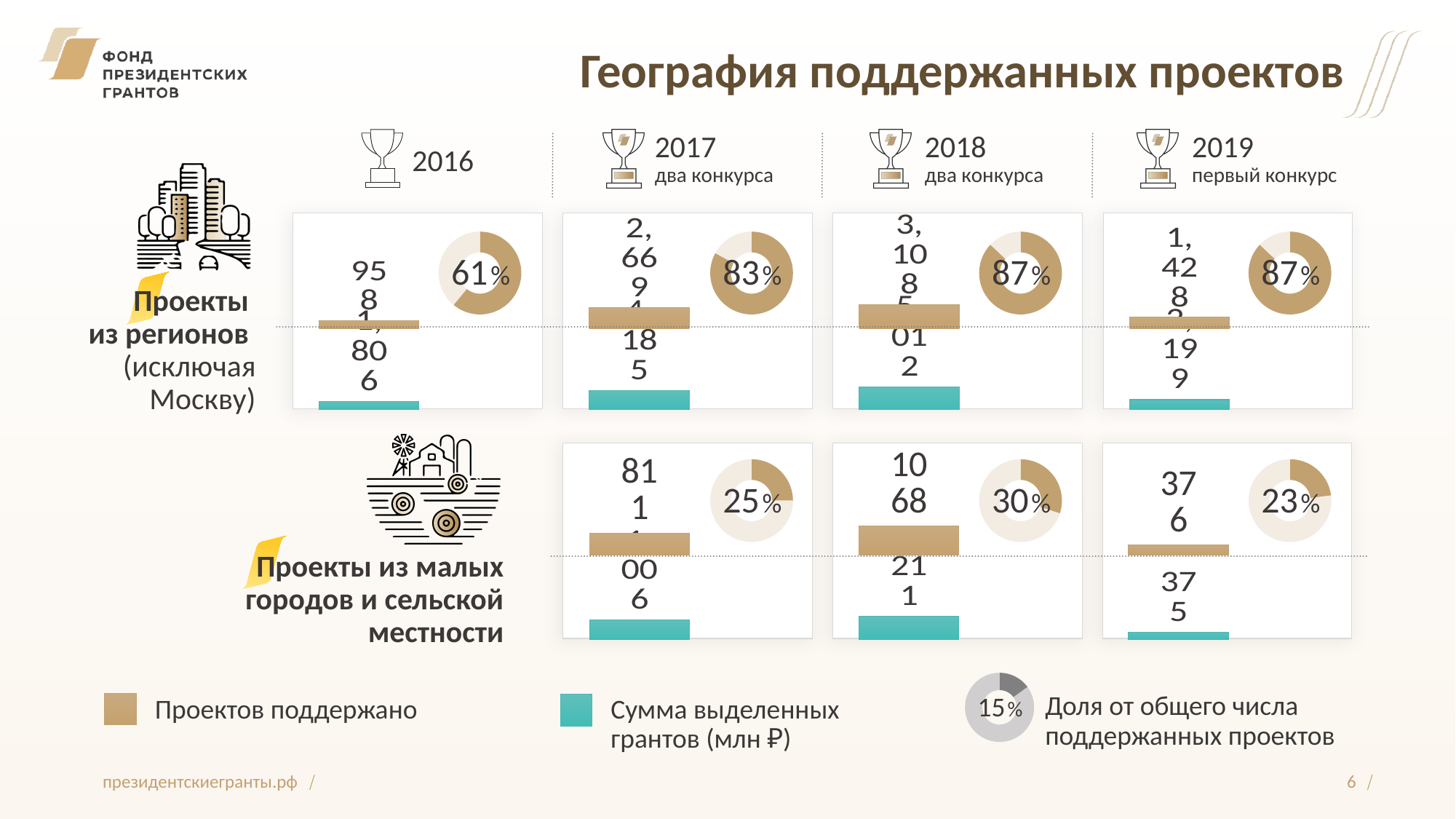
In the 'Проекты из регионов' row, does the share of supported projects rise or fall from 2016 to 2018? Rise In the 'Проекты из регионов' row, what share is shown in the donut chart for 2019? 87% In the 'Проекты из малых городов и сельской местности' row, what share is shown in the donut chart for 2019? 23% In the 'Проекты из малых городов и сельской местности' row, what share is shown in the donut chart for 2017? 25% In the 'Проекты из регионов' row, what share of the total number of supported projects is shown for 2016? 61% In the 'Проекты из регионов' row, by how many percentage points does the 2017 share exceed the 2016 share? 22 percentage points In the 'Проекты из малых городов и сельской местности' row, which year has the larger share: 2017 or 2019? 2017 In the 'Проекты из регионов' row, which year has the lowest share of supported projects? 2016 What kind of chart is used to show the share of the total number of supported projects in each box? Donut (pie) chart In the 'Проекты из малых городов и сельской местности' row, which year has the highest share of supported projects? 2018 In the 'Проекты из малых городов и сельской местности' row, what share is shown in the donut chart for 2018? 30% In the 'Проекты из регионов' row, what share is shown in the donut chart for 2017? 83%